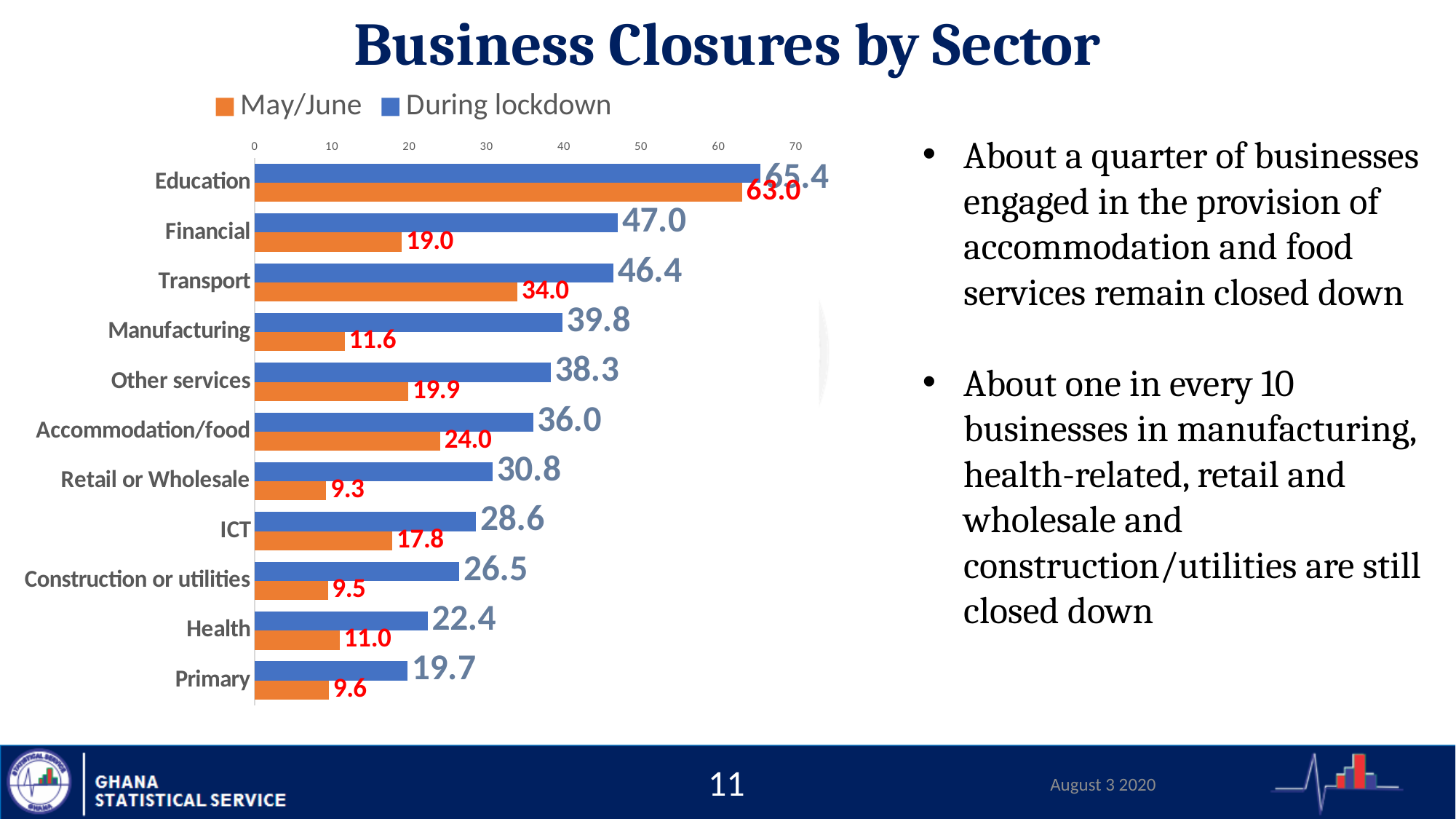
How many sectors are shown in the chart? 11 What is the May/June value for Financial? 19.0 What kind of chart is shown on the slide? Bar chart What is the difference between the During lockdown and May/June values for Manufacturing? 28.2 Which sector has the lowest May/June value? Retail or Wholesale What is the May/June value for Accommodation/food? 24.0 Which sector has the highest During lockdown value? Education What is the title of the chart? Business Closures by Sector Which is larger: the May/June value for Transport or the May/June value for ICT? Transport Which colour represents the May/June series? Orange What is the During lockdown value for Education? 65.4 How many series does the legend list? 2